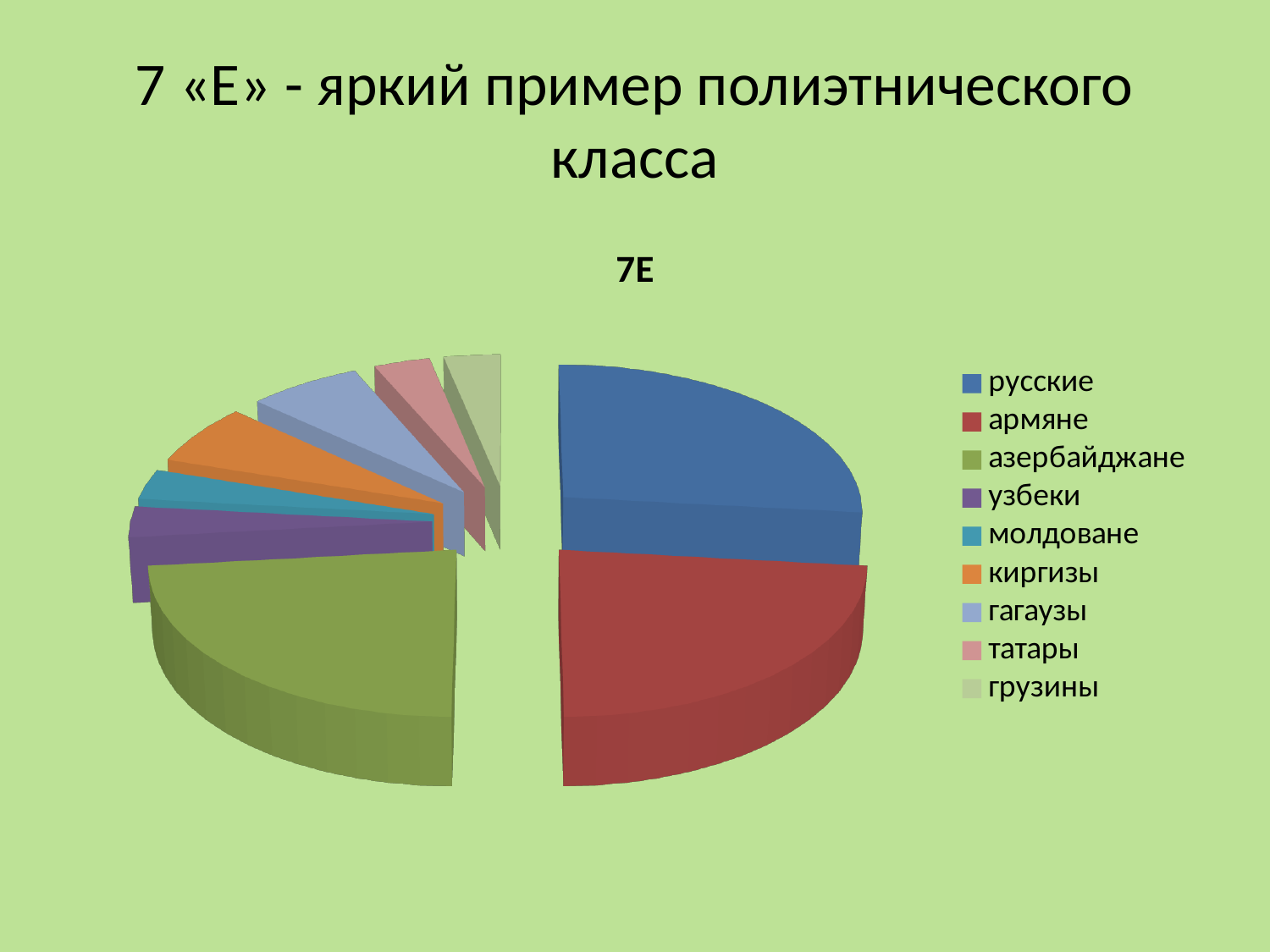
Which is larger in the pie chart, the slice for азербайджане or the slice for киргизы? азербайджане What is the title of the chart? 7Е What kind of chart is shown on the slide? pie chart Which is larger in the pie chart, the slice for армяне or the slice for татары? армяне Which is larger in the pie chart, the slice for киргизы or the slice for молдоване? киргизы Which category is shown in blue in the pie chart? русские How many categories does the pie chart have? 9